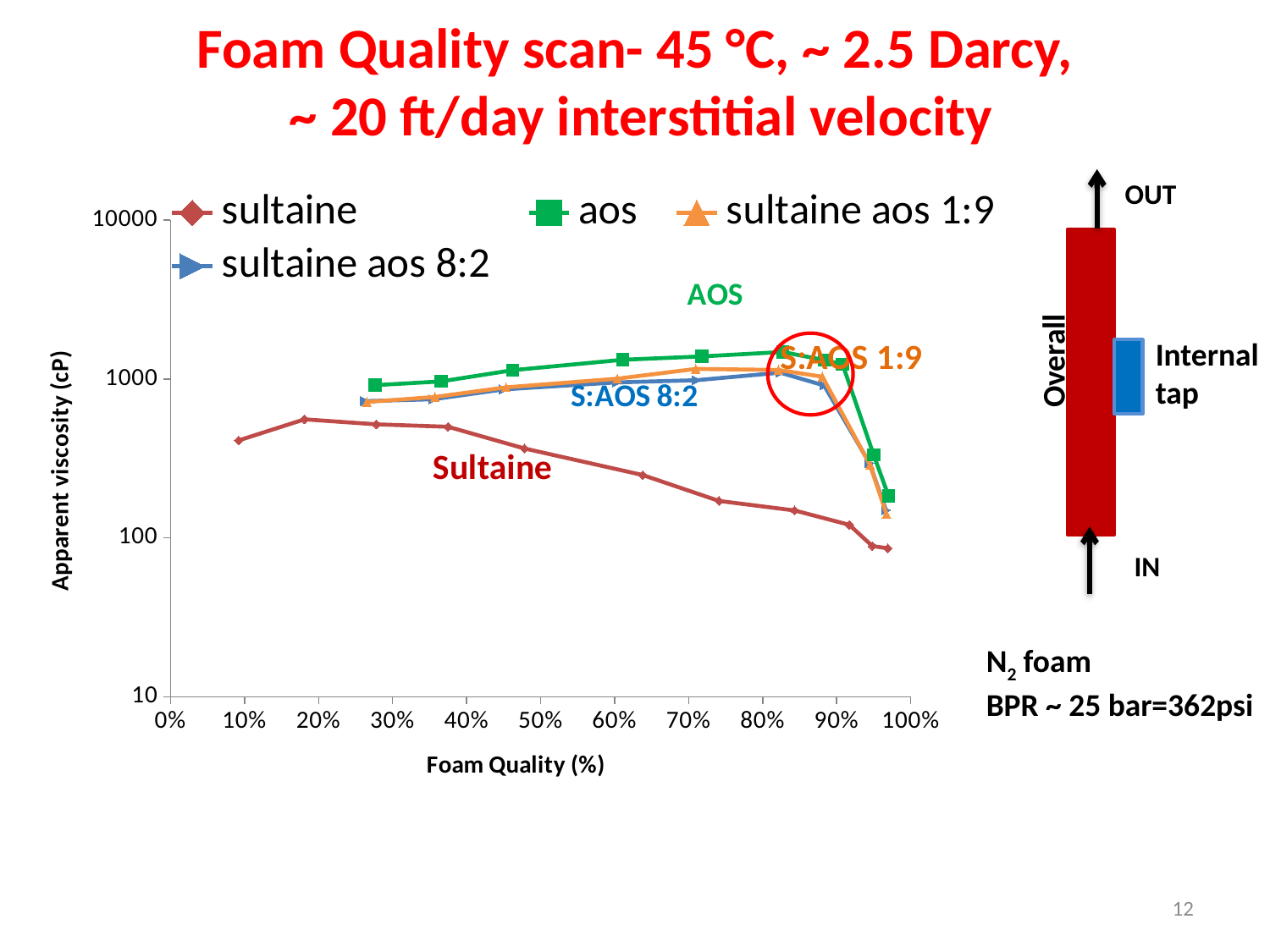
What kind of chart is shown on the slide? line chart Is the apparent viscosity of the sultaine series at about 10% foam quality greater or less than 1000? less Is the apparent viscosity of the aos series at about 60% foam quality greater or less than 1000? greater What is the label of the y axis of the chart? Apparent viscosity (cP) Does the apparent viscosity of the sultaine series rise or fall as foam quality increases from 20% to 95%? fall Does the apparent viscosity of the aos series rise or fall as foam quality increases from 30% to 80%? rise Which series has the lowest apparent viscosity across the foam quality range? sultaine At about 60% foam quality, which series has the larger apparent viscosity, aos or sultaine? aos Is the apparent viscosity of the sultaine series at about 75% foam quality greater or less than 100? greater What is the label of the x axis of the chart? Foam Quality (%) Which series has the highest apparent viscosity at around 60% foam quality? aos How many series does the chart legend list? 4